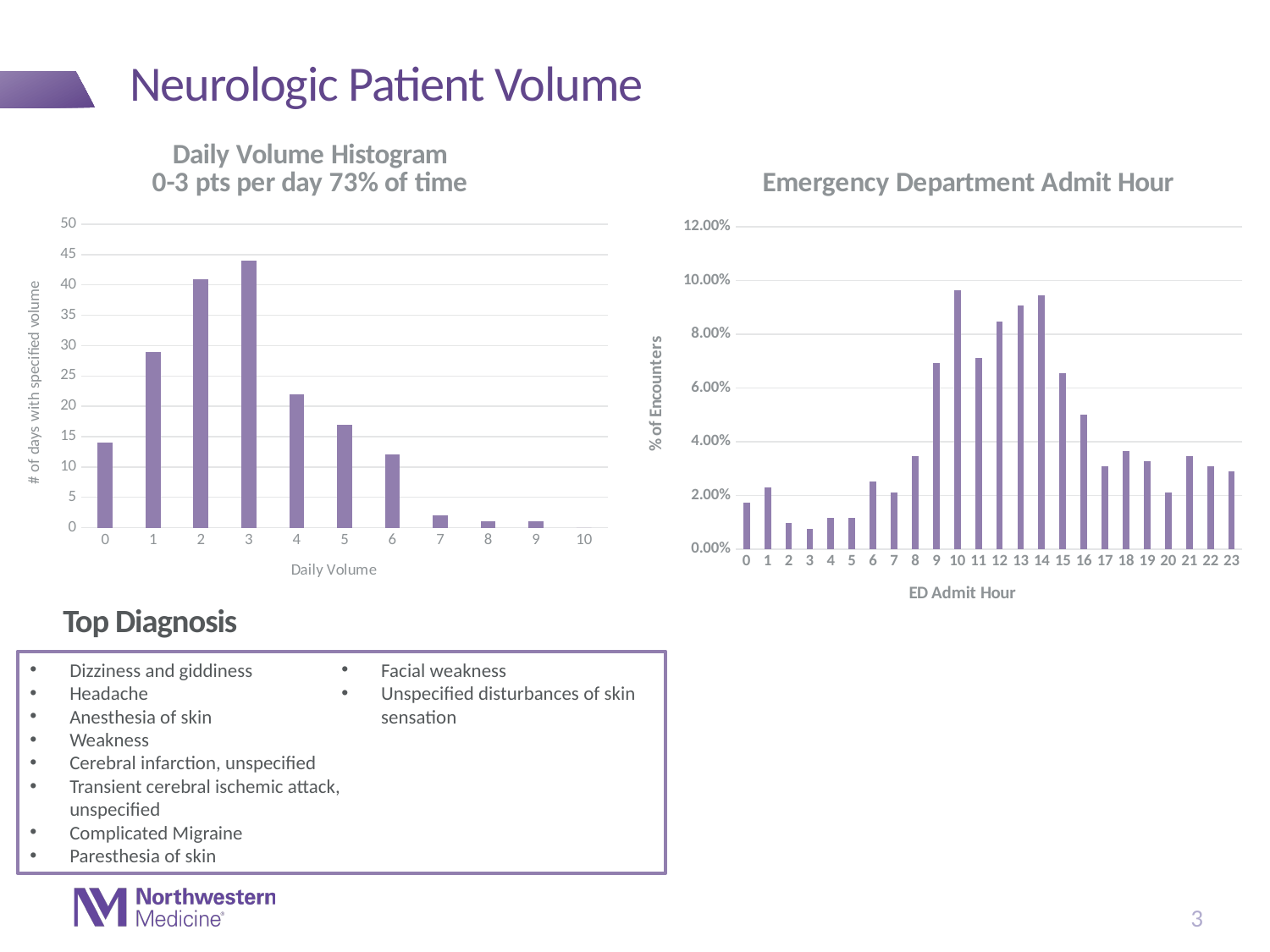
In the Daily Volume Histogram, which is larger, the value for daily volume 1 or daily volume 4? daily volume 1 In the Emergency Department Admit Hour chart, how many admit hours are shown on the x axis? 24 In the Emergency Department Admit Hour chart, which is larger, the value for hour 12 or hour 6? hour 12 In the Emergency Department Admit Hour chart, is the value for hour 0 greater or less than 2.00%? less In the Daily Volume Histogram, what is the label of the y axis? # of days with specified volume In the Daily Volume Histogram, is the value for daily volume 0 greater or less than 15? less In the Daily Volume Histogram, how many daily volume categories are shown on the x axis? 11 What kind of chart is the Daily Volume Histogram on the left? bar chart In the Daily Volume Histogram, is the value for daily volume 2 greater or less than 40? greater In the Emergency Department Admit Hour chart, what is the label of the y axis? % of Encounters In the Daily Volume Histogram, which daily volume has the highest number of days? 3